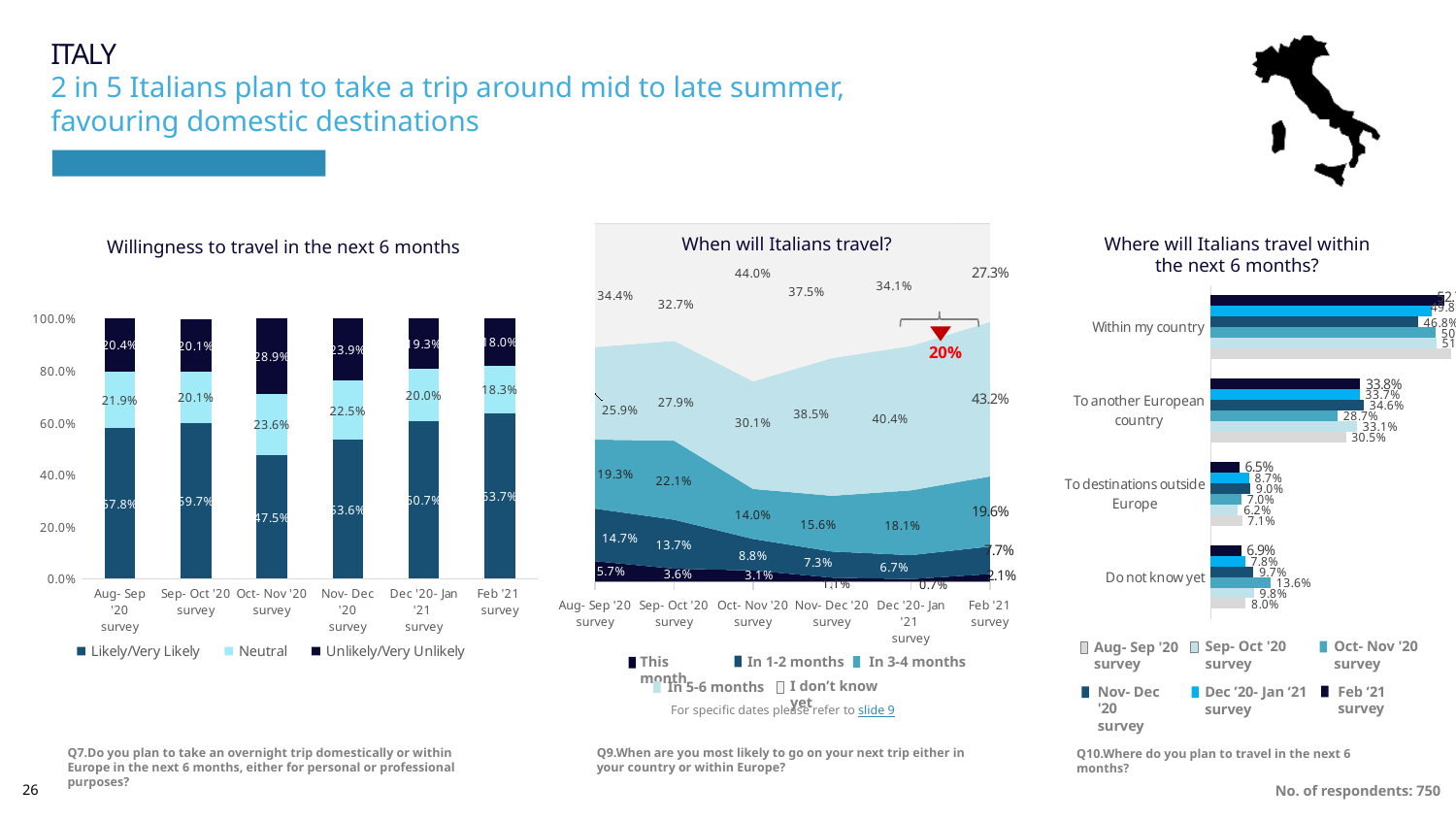
What kind of chart is 'Where will Italians travel within the next 6 months?'? Bar chart In the 'Willingness to travel in the next 6 months' chart, what is the difference between the Likely/Very Likely values for the Feb '21 survey and the Aug- Sep '20 survey? 5.9% In the 'Willingness to travel in the next 6 months' chart, which survey has the lowest Likely/Very Likely value? Oct- Nov '20 survey In the 'When will Italians travel?' chart, is the 'In 5-6 months' value higher for the Feb '21 survey or the Aug- Sep '20 survey? Feb '21 survey In the 'When will Italians travel?' chart, which survey has the highest 'I don't know yet' value? Oct- Nov '20 survey In the 'When will Italians travel?' chart, what is the 'In 5-6 months' value for the Dec '20- Jan '21 survey? 40.4% In the 'Willingness to travel in the next 6 months' chart, how many series does the legend list? 3 In the 'When will Italians travel?' chart, what is the 'I don't know yet' value for the Feb '21 survey? 27.3% In the 'Willingness to travel in the next 6 months' chart, what is the Neutral value for the Oct- Nov '20 survey? 23.6% In the 'Where will Italians travel within the next 6 months?' chart, what is the Nov- Dec '20 survey value for 'Do not know yet'? 9.7% In the 'Willingness to travel in the next 6 months' chart, what is the Likely/Very Likely value for the Feb '21 survey? 63.7% In the 'When will Italians travel?' chart, how many surveys are shown along the x axis? 6